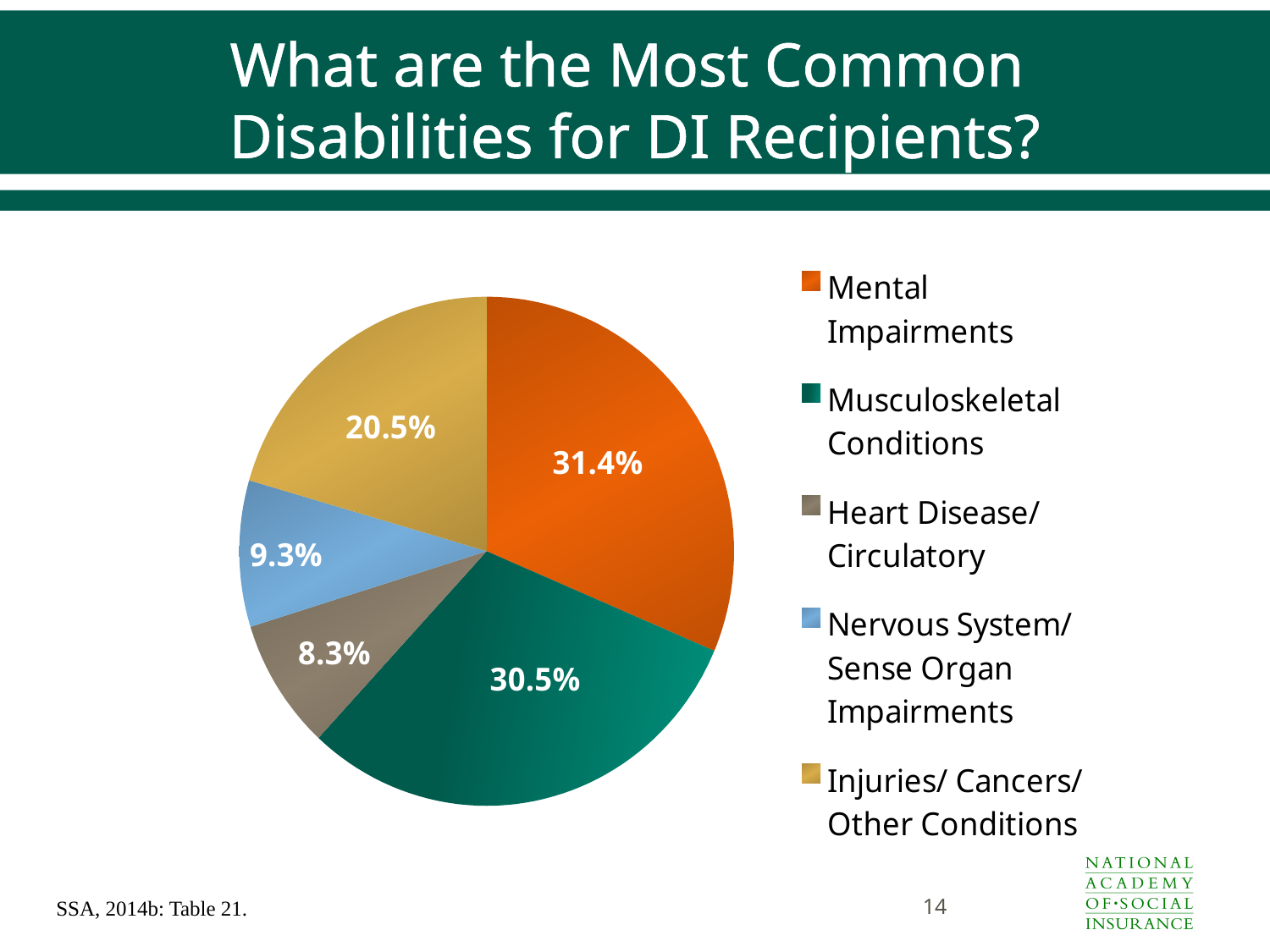
What share of DI recipients have Mental Impairments as their disability? 31.4% Which category has the smallest slice of the pie? Heart Disease/ Circulatory What is the difference in percentage points between Injuries/ Cancers/ Other Conditions and Nervous System/ Sense Organ Impairments? 11.2 Which category has the largest slice of the pie? Mental Impairments What percentage of the pie is Musculoskeletal Conditions? 30.5% How many categories does the pie chart show? 5 Which is larger, the share for Nervous System/ Sense Organ Impairments or the share for Heart Disease/ Circulatory? Nervous System/ Sense Organ Impairments What is the value shown for Heart Disease/ Circulatory? 8.3% What kind of chart is shown on the slide? Pie chart What share is labelled for Injuries/ Cancers/ Other Conditions? 20.5% What percentage is shown for Nervous System/ Sense Organ Impairments? 9.3% What is the difference in percentage points between Mental Impairments and Musculoskeletal Conditions? 0.9